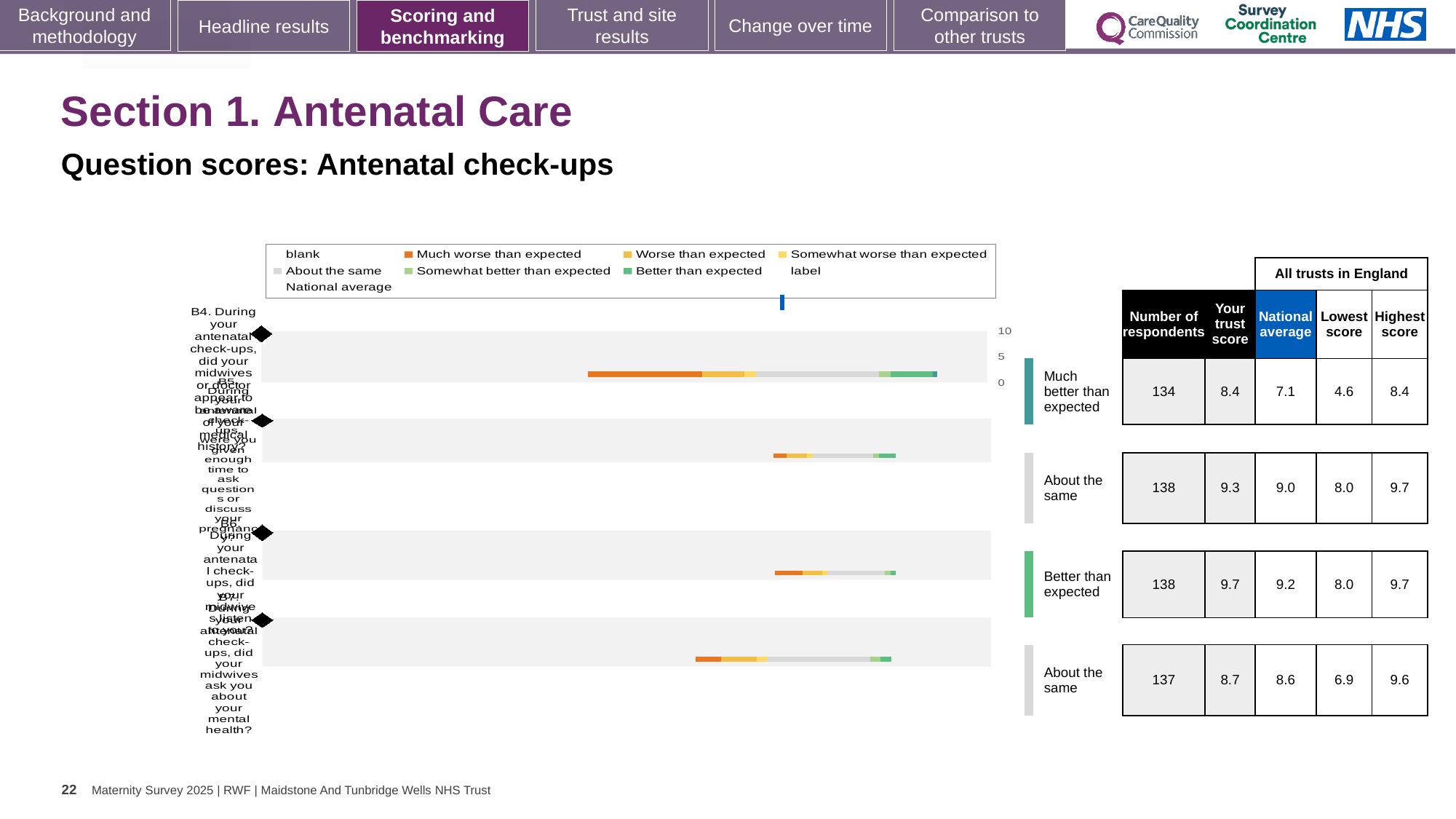
What is the national average for the third bar, rated 'Better than expected'? 9.2 How many respondents answered the question in the top bar (question B4)? 134 What is the highest score across all trusts in England for the bottom (fourth) bar? 9.6 What colour does the legend use for 'Much worse than expected'? orange What is the trust score for the top bar (question B4), rated 'Much better than expected'? 8.4 What kind of chart is shown on the slide? bar chart For the top bar (question B4), how much higher is the trust score than the national average? 1.3 For the second bar, which is larger: the trust score or the national average? the trust score (9.3) What is the national average for the top bar (question B4)? 7.1 Which bar has the lowest 'Lowest score' across all trusts in England? the top bar (question B4), 4.6 How many question bars are plotted in the chart? 4 Which bar has the highest trust score? the third bar (Better than expected), 9.7